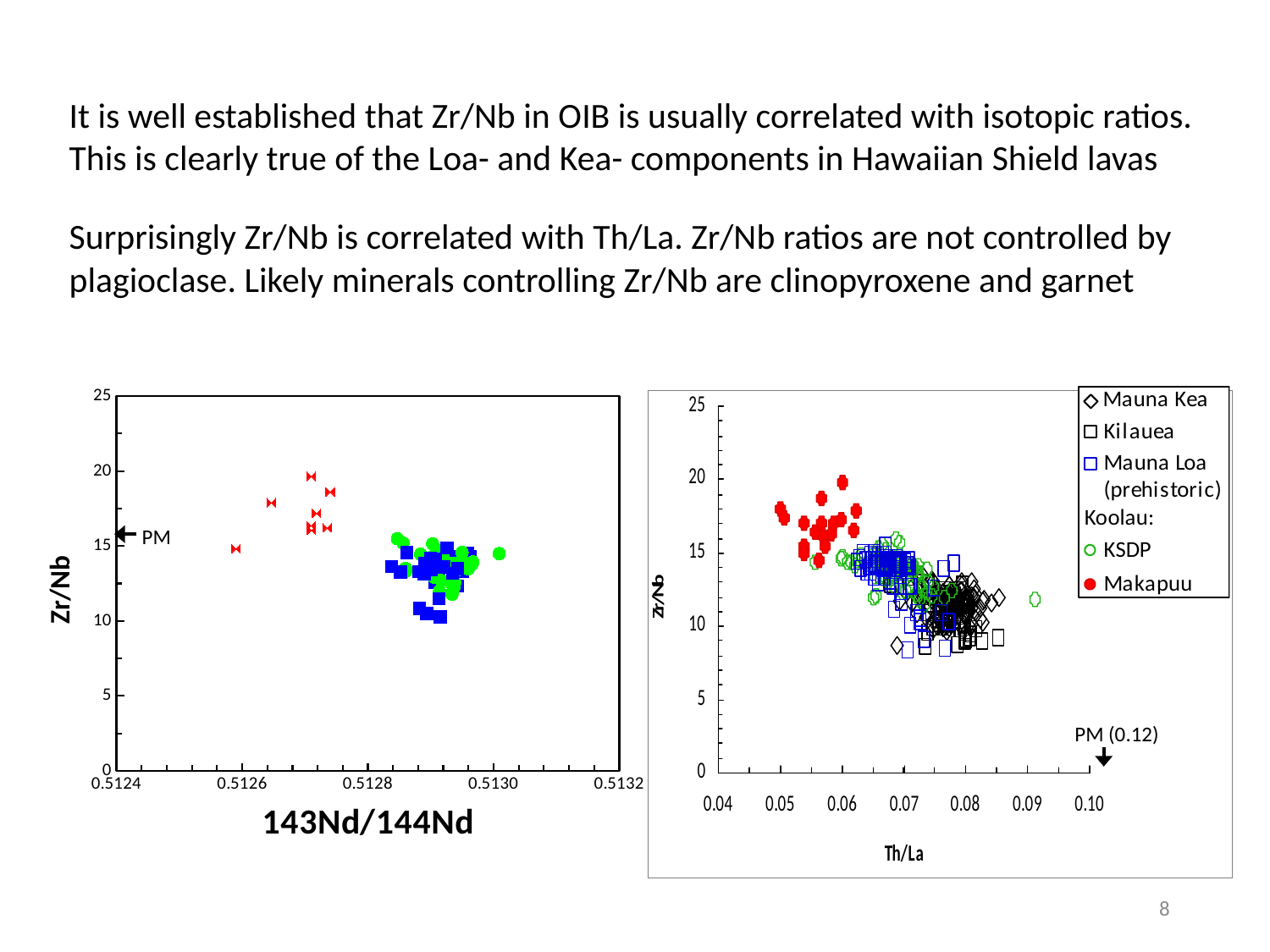
In the left chart, what is the maximum value shown on the Zr/Nb axis? 25 In the right chart, what Th/La value is given for PM in the annotation? 0.12 In the right chart, how many series does the legend list? 5 In the left chart, what is the label of the x axis? 143Nd/144Nd What kind of chart is the left chart (Zr/Nb vs 143Nd/144Nd)? Scatter chart In the left chart, are the 143Nd/144Nd values of the red points greater or less than 0.5128? less In the right chart, are the Th/La values of the Makapuu points greater or less than 0.07? less In the right chart, which series has higher Zr/Nb values, Makapuu or Mauna Kea? Makapuu In the right chart, which series is shown with filled red circles? Makapuu What kind of chart is the right chart (Zr/Nb vs Th/La)? Scatter chart In the right chart, are the Th/La values of the Mauna Kea points greater or less than 0.06? greater